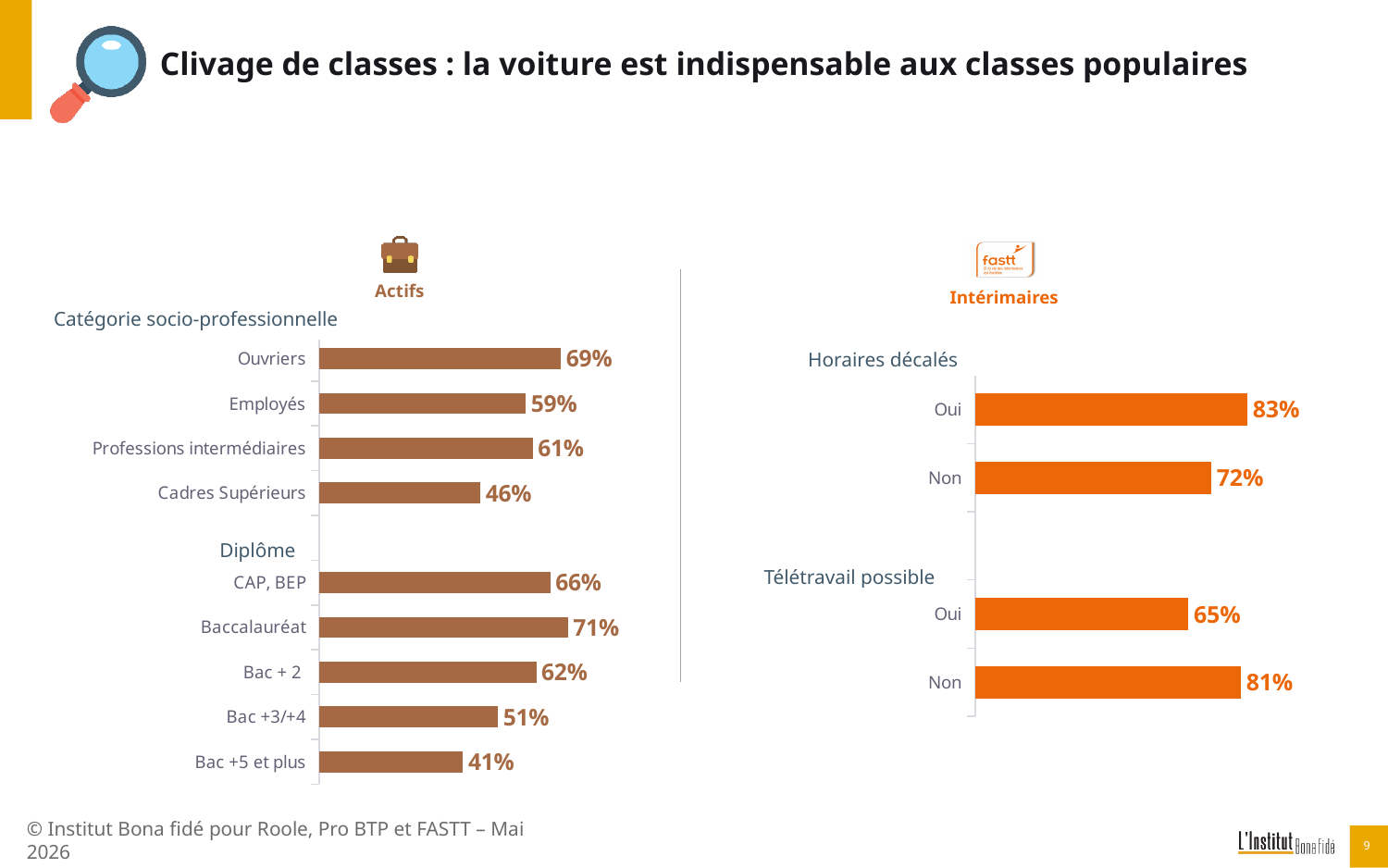
In the Actifs chart, which category has the lowest value? Bac +5 et plus In the Intérimaires chart, what is the difference between Oui and Non under Télétravail possible? 16 percentage points In the Intérimaires chart, which has the lowest value? Télétravail possible – Oui In the Actifs chart, what is the difference between Ouvriers and Cadres Supérieurs? 23 percentage points In the Actifs chart, which category has the highest value? Baccalauréat In the Actifs chart, what is the value for Cadres Supérieurs? 46% What type of chart is the Intérimaires chart? Bar chart In the Intérimaires chart, what is the value for Non under Télétravail possible? 81% In the Actifs chart, what is the value for Ouvriers? 69% In the Actifs chart, which is larger, Employés or Professions intermédiaires? Professions intermédiaires In the Intérimaires chart, what is the value for Oui under Horaires décalés? 83% How many categories are plotted in the Actifs chart? 9